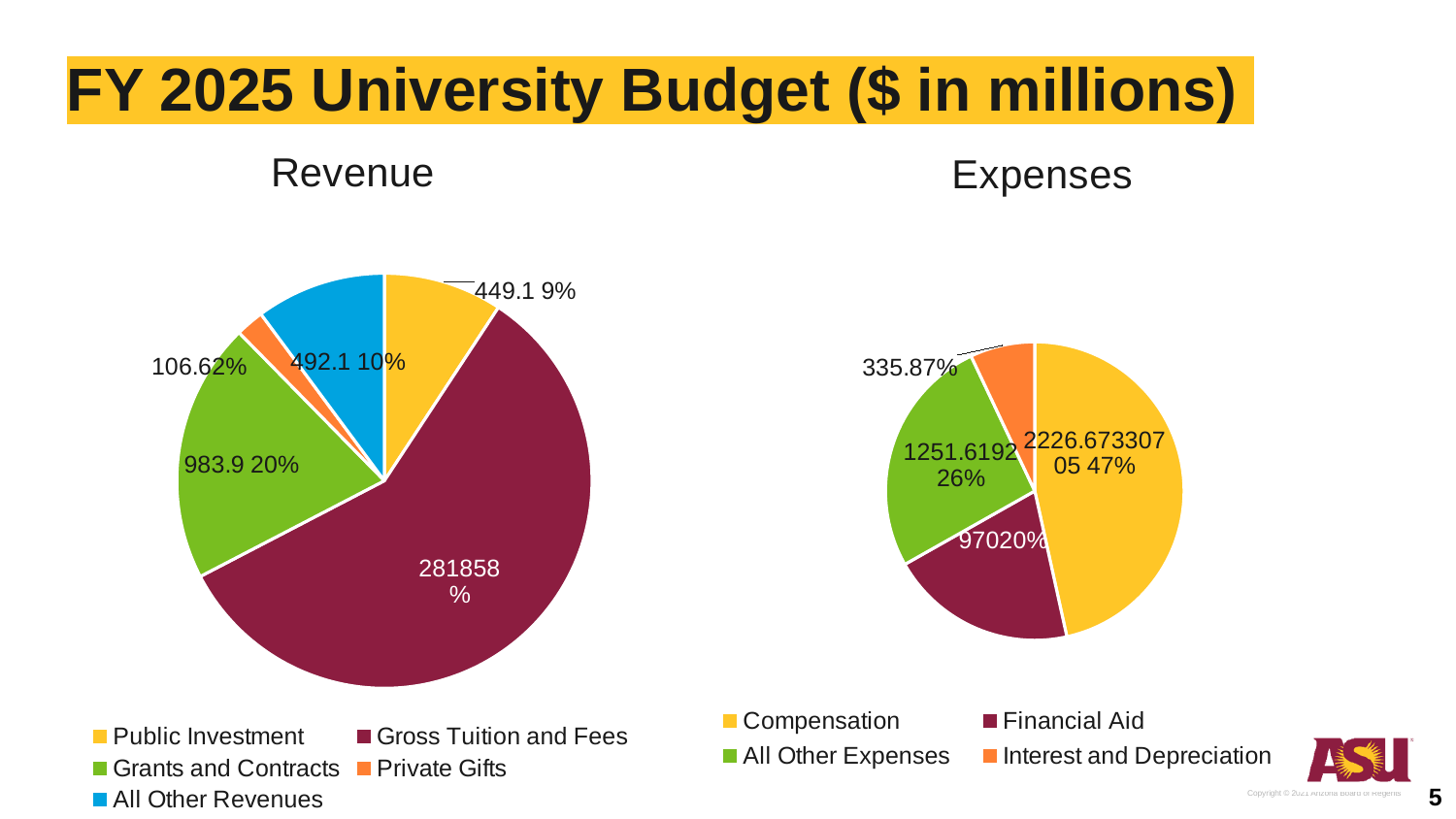
In the Expenses chart, what share of expenses is Compensation? 47% In the Revenue chart, what share of revenue is Public Investment? 9% In the Revenue chart, which category has the smallest slice? Private Gifts In the Revenue chart, which category has the largest slice? Gross Tuition and Fees What kind of chart is the Revenue chart? Pie chart How many slices does the Revenue pie chart have? 5 In the Revenue chart, what is the value for Grants and Contracts? 983.9 How many categories does the legend of the Expenses chart list? 4 In the Expenses chart, which category has the smallest slice? Interest and Depreciation In the Expenses chart, which category has the largest slice? Compensation In the Revenue chart, what is the difference between Grants and Contracts (983.9) and Public Investment (449.1)? 534.8 In the Revenue chart, which is larger: Grants and Contracts or All Other Revenues? Grants and Contracts